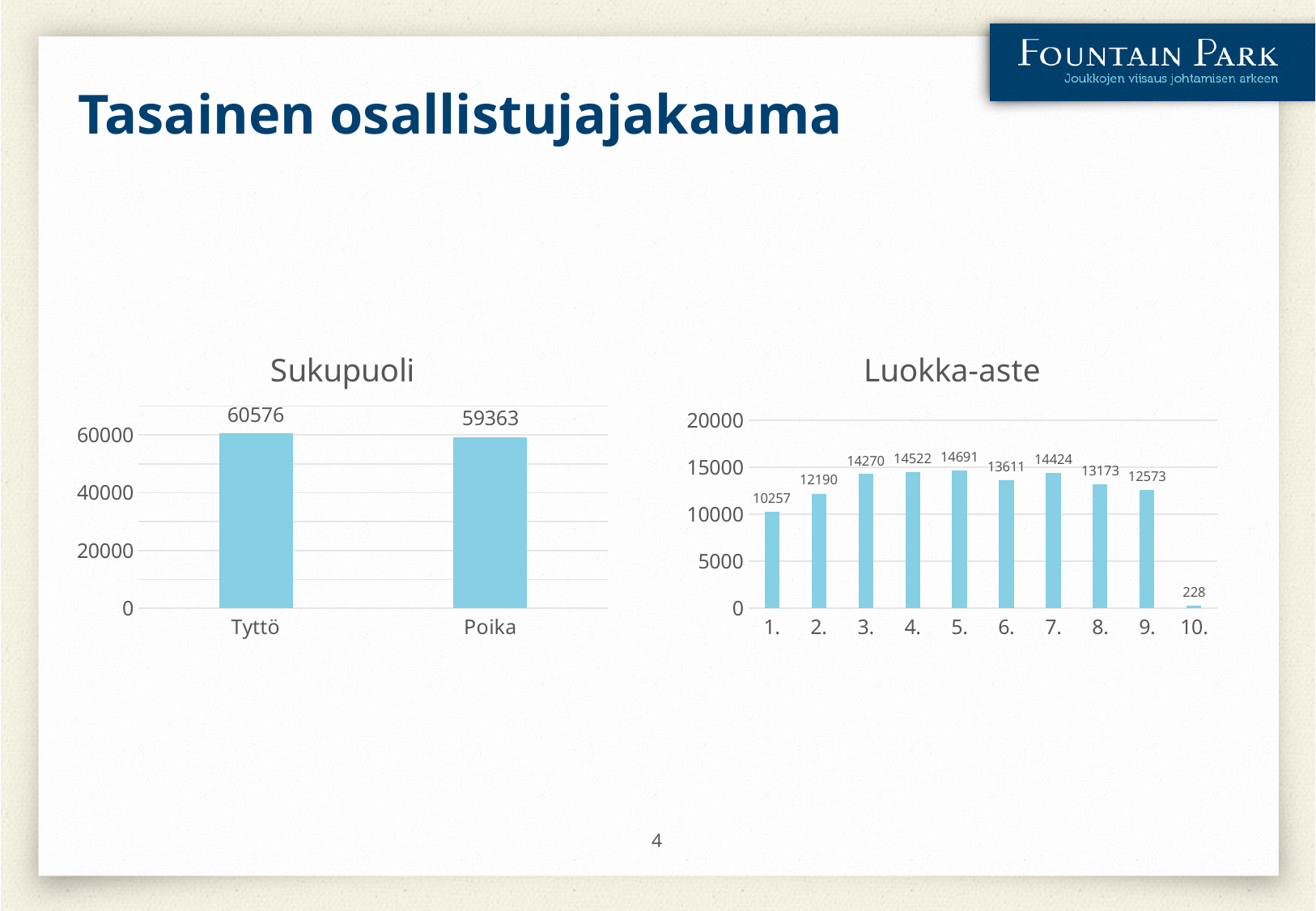
In the Luokka-aste chart, what is the value for grade 5.? 14691 In the Luokka-aste chart, what is the value for grade 10.? 228 In the Luokka-aste chart, what is the difference between the values for grade 4. and grade 1.? 4265 In the Sukupuoli chart, what is the difference between the values for Tyttö and Poika? 1213 In the Sukupuoli chart, what is the value for Tyttö? 60576 In the Sukupuoli chart, how many categories are shown? 2 In the Luokka-aste chart, which is larger, the value for grade 3. or grade 8.? 3. In the Luokka-aste chart, which grade has the highest value? 5. What kind of chart is the Luokka-aste chart? Bar chart In the Luokka-aste chart, which grade has the lowest value? 10. In the Luokka-aste chart, how many grade categories are shown? 10 In the Sukupuoli chart, what is the value for Poika? 59363